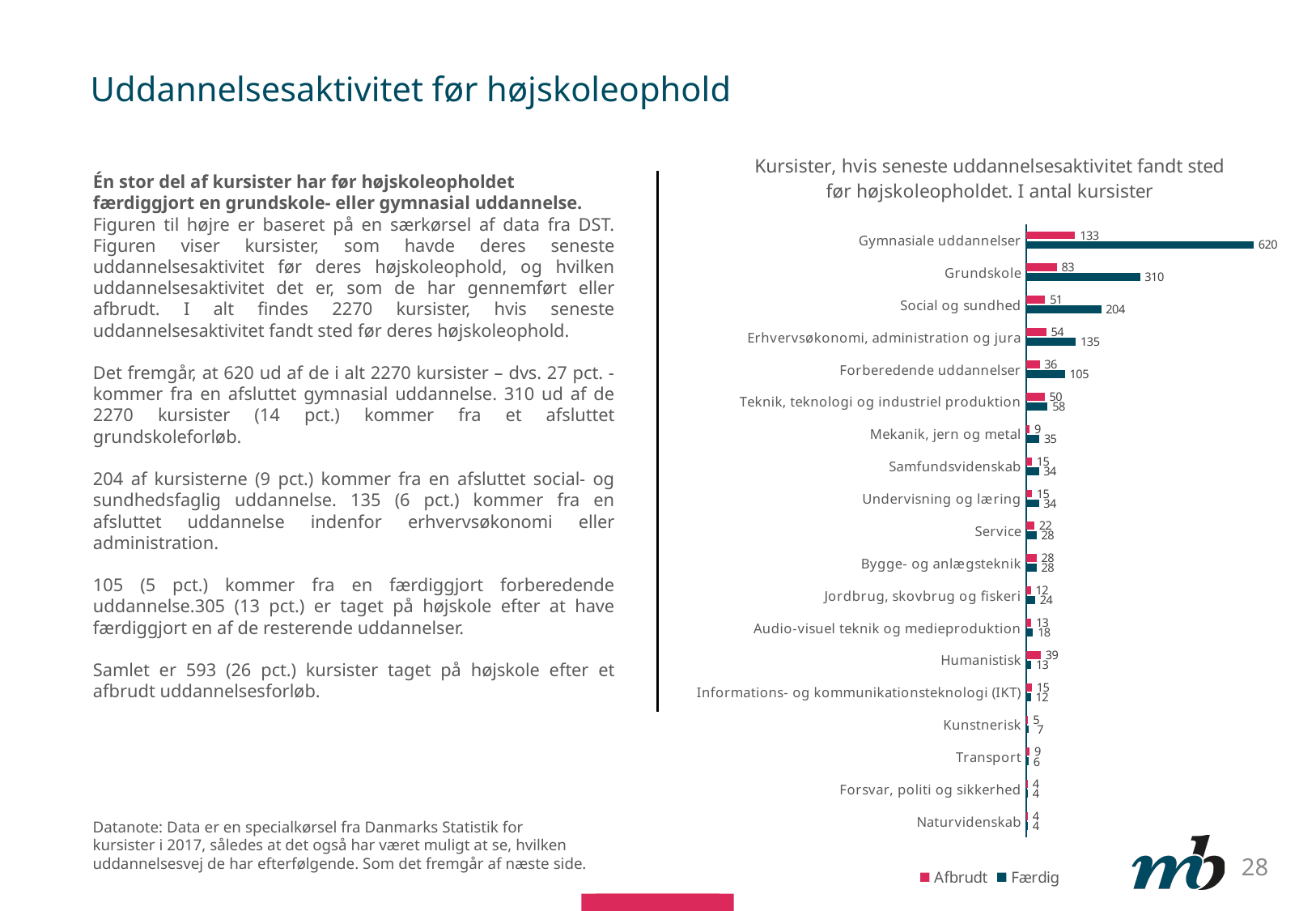
What is the difference between the Færdig and Afbrudt values for Grundskole? 227 What type of chart is shown on the slide? bar chart What is the total of the Afbrudt and Færdig values for Forberedende uddannelser? 141 Which category has the highest Færdig value? Gymnasiale uddannelser What is the Afbrudt value for Humanistisk? 39 What is the Færdig value for Gymnasiale uddannelser? 620 What is the Afbrudt value for Grundskole? 83 How many series does the chart legend list? 2 Which is larger for Humanistisk, the Afbrudt value or the Færdig value? Afbrudt What is the title of the chart? Kursister, hvis seneste uddannelsesaktivitet fandt sted før højskoleopholdet. I antal kursister How many categories are shown on the chart? 19 What is the Færdig value for Social og sundhed? 204